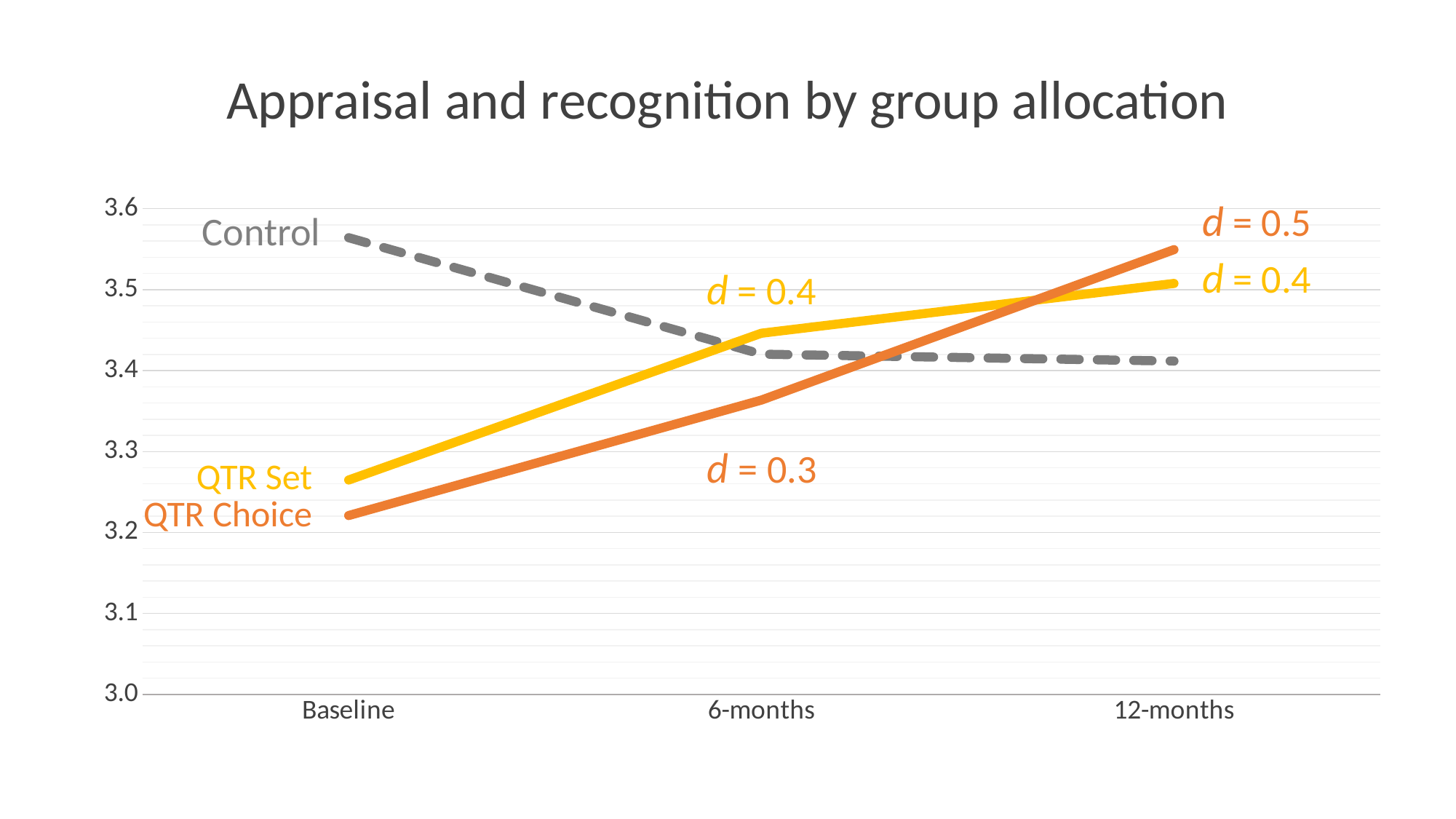
At Baseline, which is larger: Control or QTR Choice? Control Is the value for QTR Choice at 6-months greater or less than 3.4? less Is the value for Control at Baseline greater or less than 3.5? greater How many time points are shown on the x axis? 3 Is the value for QTR Choice at 12-months greater or less than 3.5? greater Does the Control line rise or fall from Baseline to 12-months? fall How many groups are plotted as lines on the chart? 3 Which group has the highest value at 12-months? QTR Choice Does the QTR Choice line rise or fall from Baseline to 12-months? rise What kind of chart is shown on the slide? line chart Which group has the lowest value at Baseline? QTR Choice